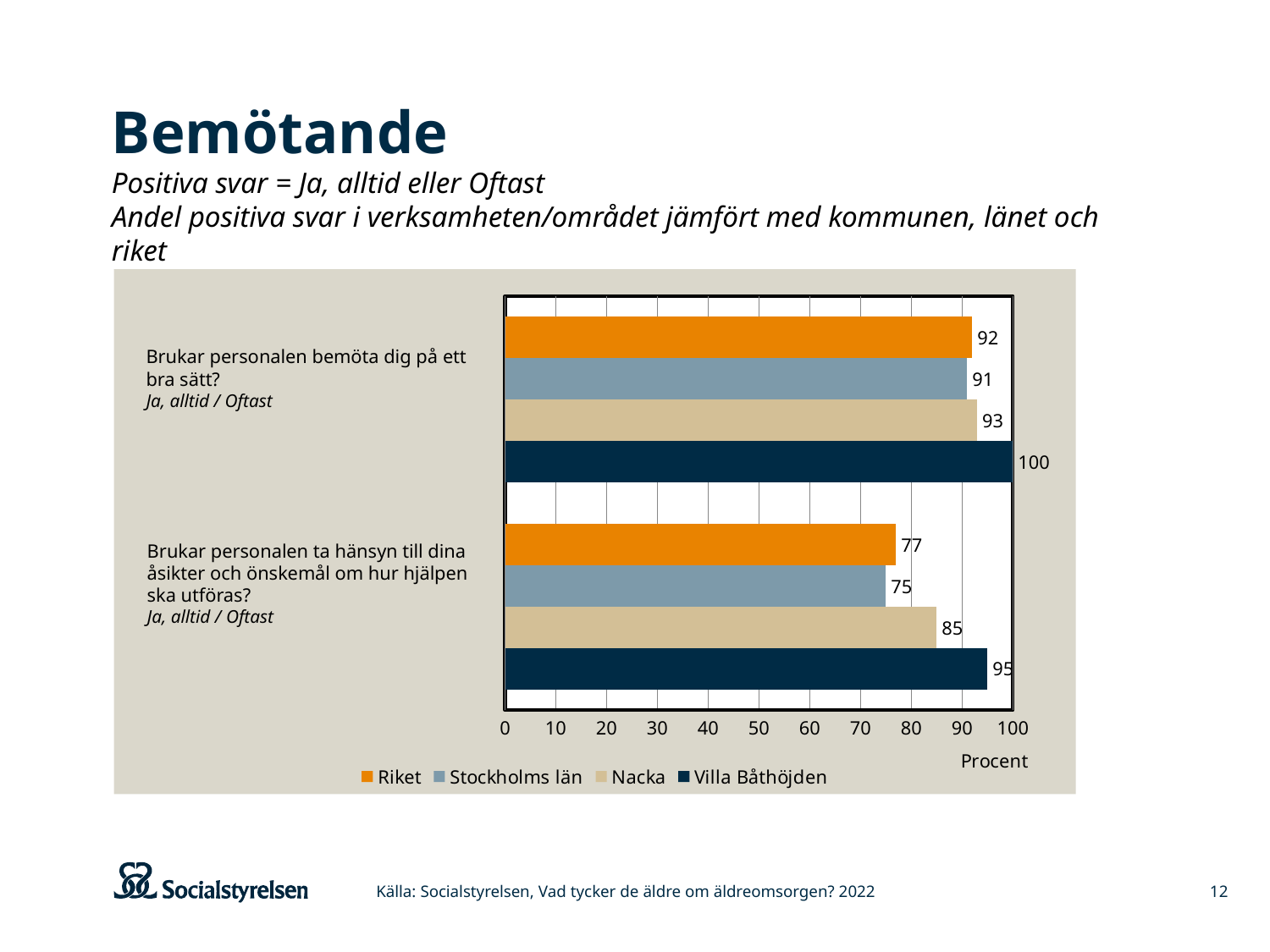
Which series has the highest value for the question 'Brukar personalen ta hänsyn till dina åsikter och önskemål om hur hjälpen ska utföras?' Villa Båthöjden What is the value for Riket for the question 'Brukar personalen ta hänsyn till dina åsikter och önskemål om hur hjälpen ska utföras?' 77 How many series does the legend list? 4 Which is larger for the question 'Brukar personalen bemöta dig på ett bra sätt?': Riket or Nacka? Nacka What is the value for Villa Båthöjden for the question 'Brukar personalen bemöta dig på ett bra sätt?' 100 What is the value for Stockholms län for the question 'Brukar personalen ta hänsyn till dina åsikter och önskemål om hur hjälpen ska utföras?' 75 What kind of chart is shown on the slide? Bar chart What is the label on the horizontal axis of the chart? Procent How many questions (categories) are shown on the chart? 2 Which series has the lowest value for the question 'Brukar personalen bemöta dig på ett bra sätt?' Stockholms län What is the value for Nacka for the question 'Brukar personalen bemöta dig på ett bra sätt?' 93 What is the difference between Villa Båthöjden and Nacka for the question 'Brukar personalen ta hänsyn till dina åsikter och önskemål om hur hjälpen ska utföras?' 10